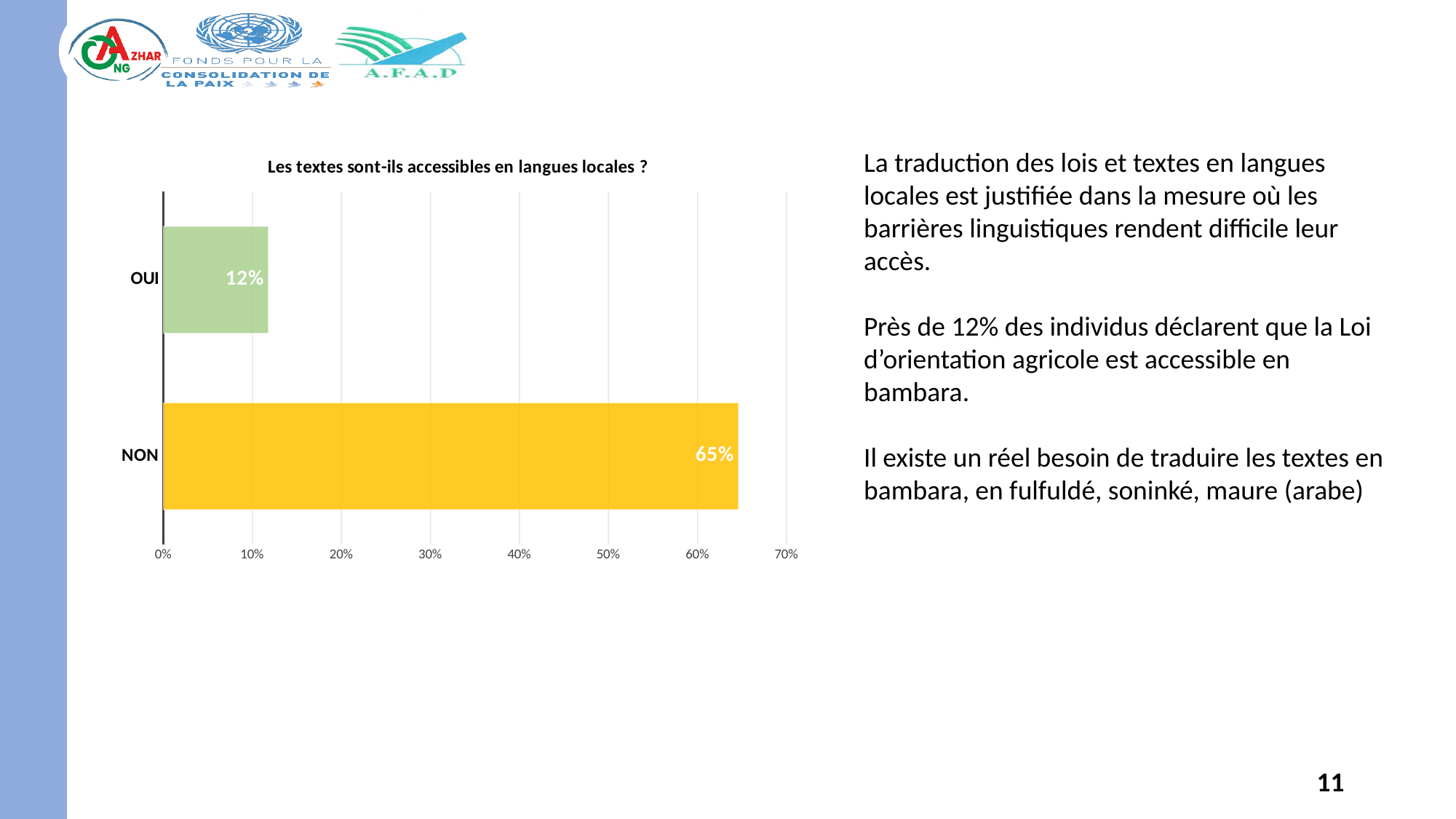
What is the value for OUI? 12% What is the difference between the values for NON and OUI? 53% What colour is the bar for NON? yellow What is the value for NON? 65% What kind of chart is shown on the slide? bar chart Which category has the lowest value? OUI What is the title of the chart? Les textes sont-ils accessibles en langues locales ? Which category has the highest value? NON Which is larger, the value for OUI or the value for NON? NON How many categories are shown in the chart? 2 Is the value for OUI greater or less than 20%? less Is the value for NON greater or less than 50%? greater